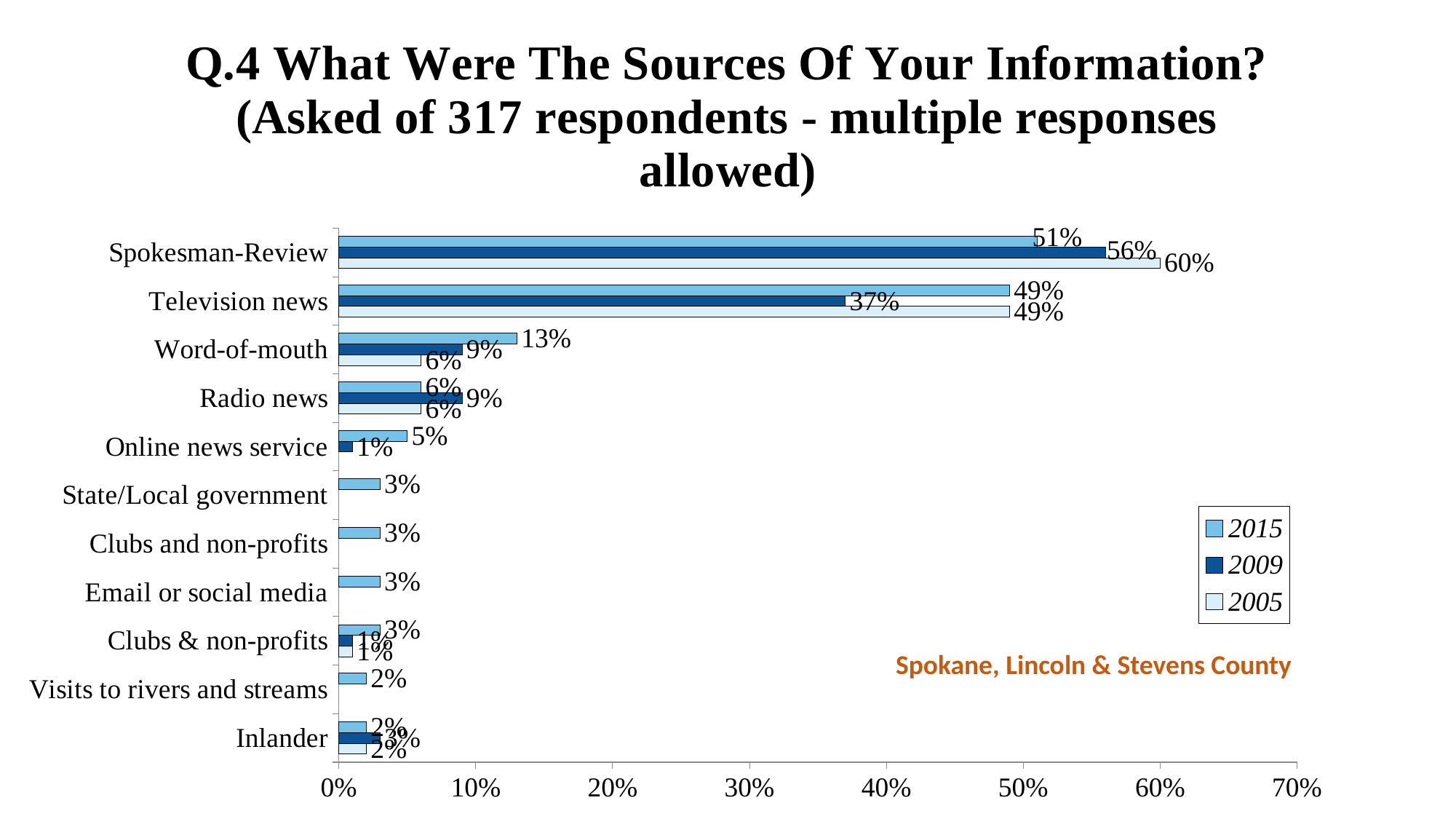
How many series does the legend list? 3 What type of chart is shown on the slide? Bar chart What percentage of respondents cited Spokesman-Review as a source in 2005? 60% How many source categories are listed on the chart? 11 What was the 2015 value for Online news service? 5% Which source had the highest value in the 2015 series? Spokesman-Review Which years are listed in the chart's legend? 2015, 2009, 2005 What is the difference between the 2015 and 2009 values for Television news? 12% What was the 2015 value for Word-of-mouth? 13% Which is larger for Radio news: the 2009 value or the 2015 value? 2009 What was the 2009 value for Television news? 37% What is the difference between the 2005 and 2015 values for Spokesman-Review? 9%